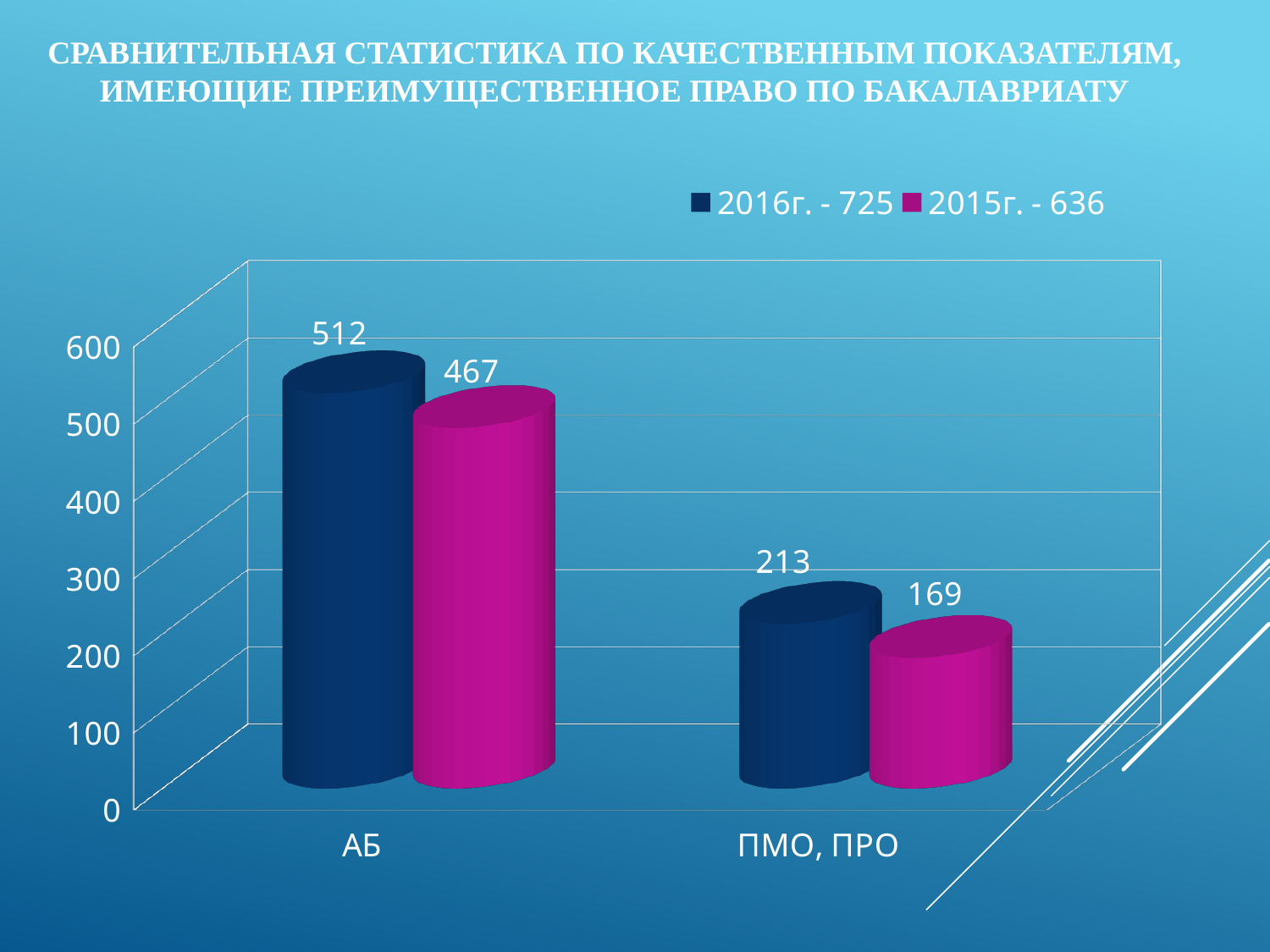
What is the difference between the 2016г. - 725 and 2015г. - 636 values for АБ? 45 Which is larger for ПМО, ПРО: the 2016г. - 725 value or the 2015г. - 636 value? 2016г. - 725 What is the difference between the 2016г. - 725 and 2015г. - 636 values for ПМО, ПРО? 44 What is the value for ПМО, ПРО in the series 2016г. - 725? 213 How many categories are shown on the x axis? 2 What is the value for ПМО, ПРО in the series 2015г. - 636? 169 What kind of chart is shown on the slide? Bar chart What is the value for АБ in the series 2015г. - 636? 467 How many series does the legend list? 2 Which category has the lowest value in the series 2015г. - 636? ПМО, ПРО What is the value for АБ in the series 2016г. - 725? 512 Which category has the highest value in the series 2016г. - 725? АБ